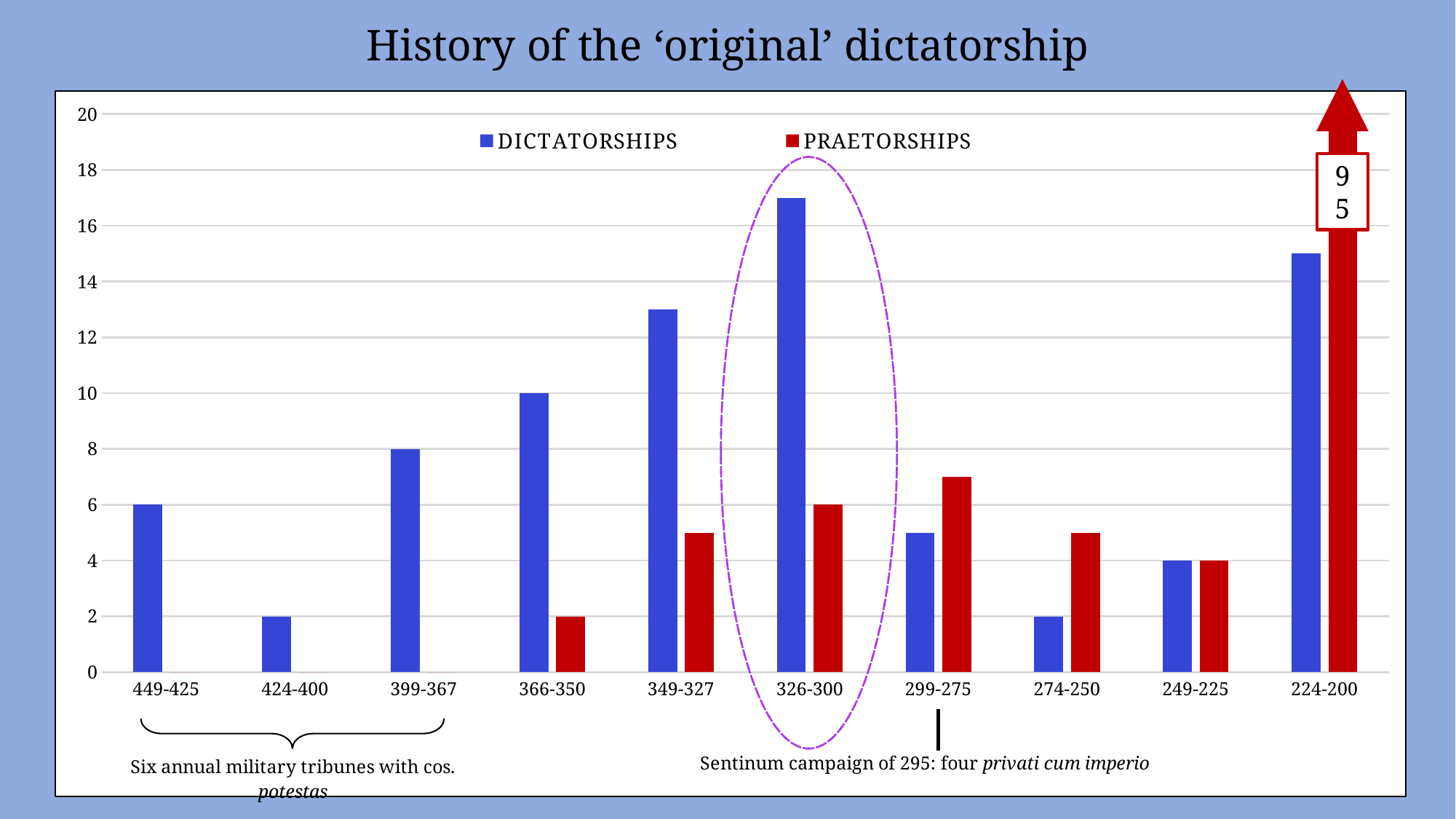
What colour represents PRAETORSHIPS in the legend? red What is the value for PRAETORSHIPS in the period 224-200? 95 What is the difference between the DICTATORSHIPS values for 449-425 and 424-400? 4 Which period has the highest value for DICTATORSHIPS? 326-300 What is the value for DICTATORSHIPS in the period 449-425? 6 Is the value for DICTATORSHIPS in the period 349-327 greater or less than 12? greater In the period 299-275, which is larger, DICTATORSHIPS or PRAETORSHIPS? PRAETORSHIPS Which period has the lowest value for PRAETORSHIPS among the periods where a PRAETORSHIPS bar is shown? 366-350 What is the value for DICTATORSHIPS in the period 366-350? 10 How many period categories are shown on the x axis? 10 What kind of chart is shown on the slide? bar chart How many series does the legend list? 2